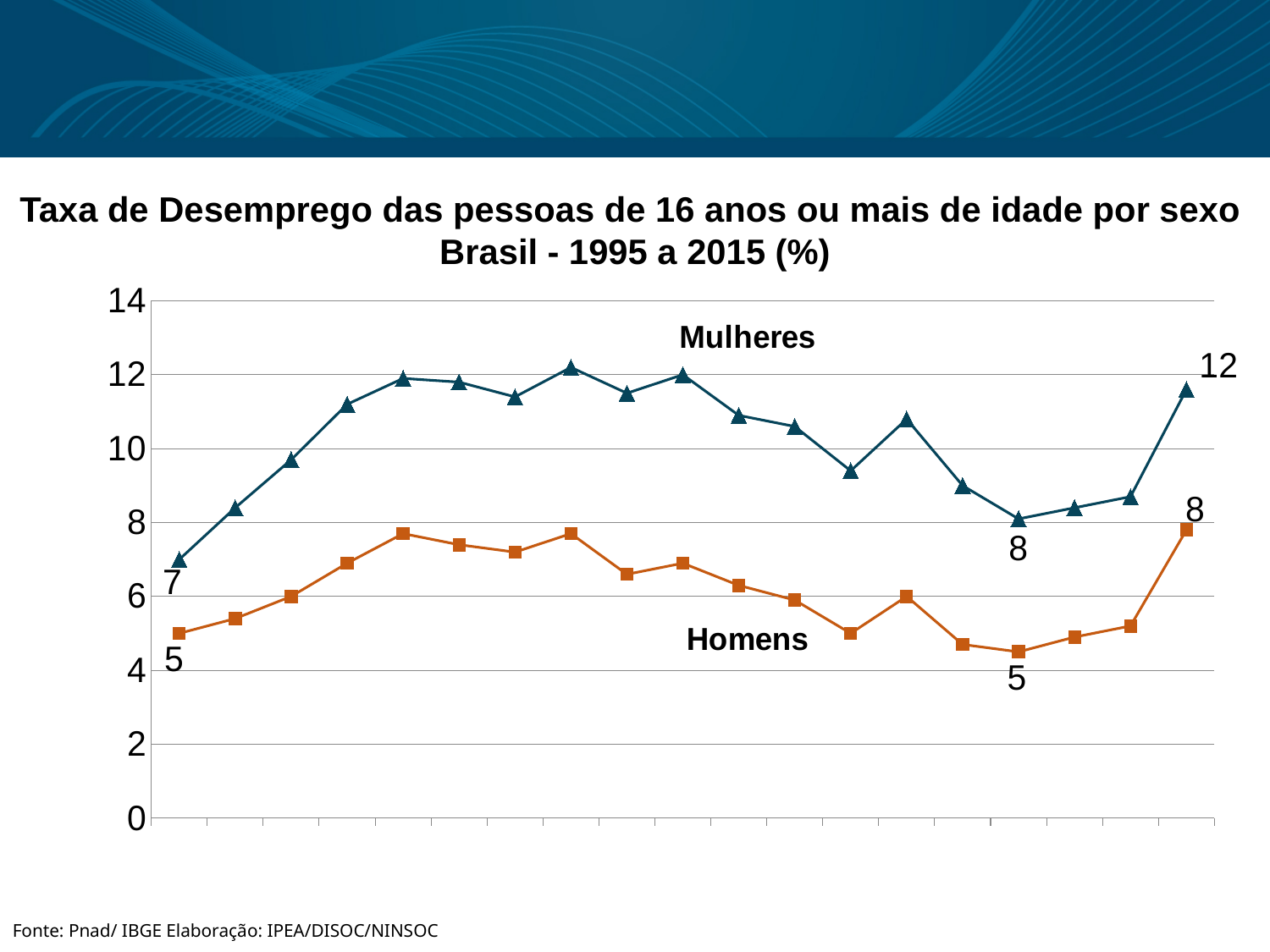
What is the value of the first plotted point of the Mulheres series? 7 How many series are plotted in the chart? 2 What is the value of the first plotted point of the Homens series? 5 What is the value of the last plotted point of the Mulheres series? 12 Does the Homens series rise or fall between its point labeled 5 near the right side and the last plotted point? rise What are the names of the two series plotted in the chart? Mulheres and Homens What kind of chart is shown on the slide? line chart What is the value of the last plotted point of the Homens series? 8 At the last plotted point, what is the difference between the Mulheres value and the Homens value? 4 At the last plotted point, which series has the higher value, Mulheres or Homens? Mulheres By how much does the Mulheres series increase from its first plotted point to its last plotted point? 5